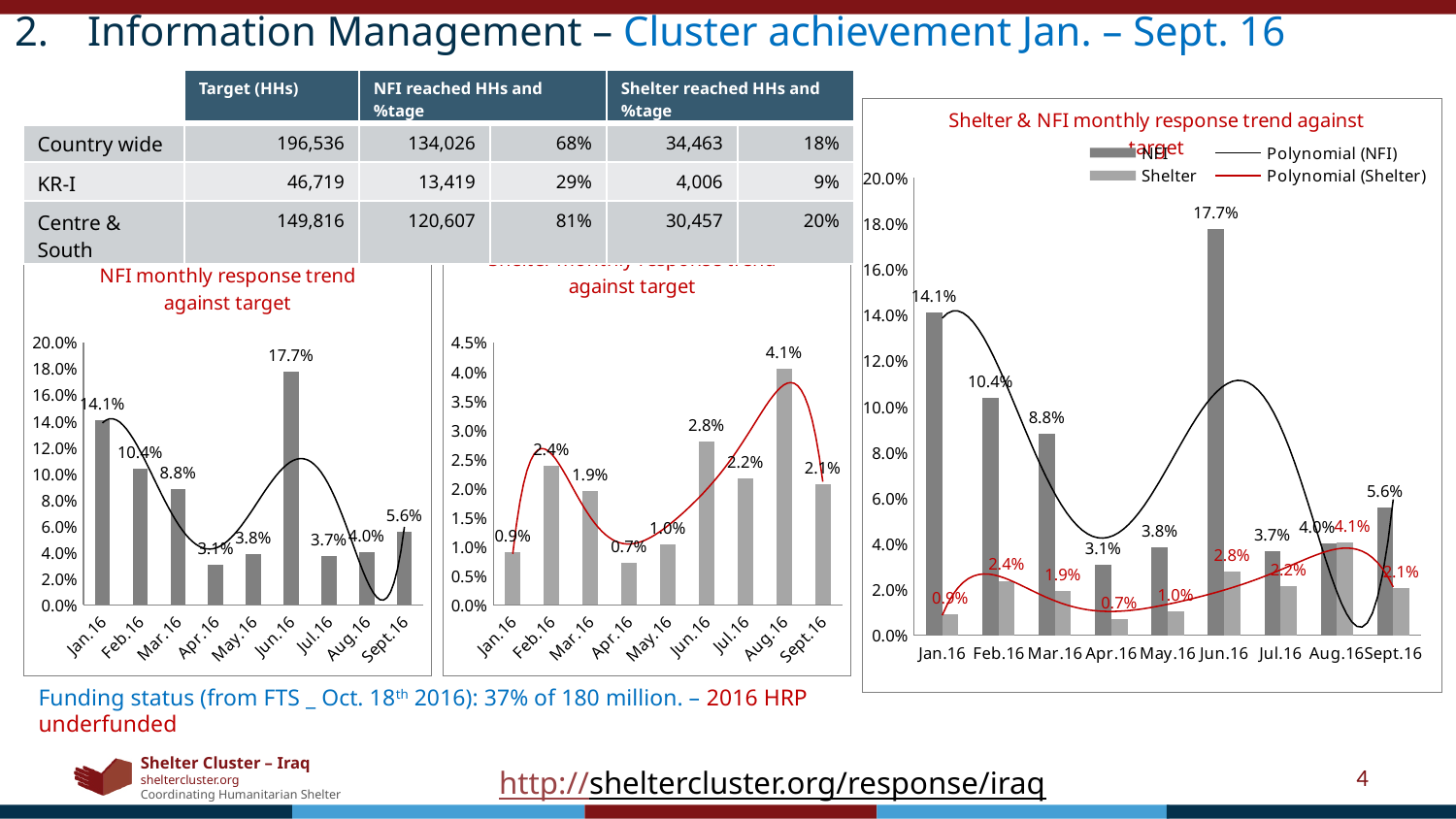
In the 'Shelter monthly response trend against target' chart, what is the value for Aug.16? 4.1% In the 'Shelter & NFI monthly response trend against target' chart, how many entries does the legend list? 4 In the 'NFI monthly response trend against target' chart, what is the difference between the Jan.16 and Feb.16 values? 3.7% In the 'Shelter monthly response trend against target' chart, which is larger, the value for Feb.16 or the value for Jul.16? Feb.16 In the 'Shelter monthly response trend against target' chart, which month has the lowest value? Apr.16 What type of chart is the 'NFI monthly response trend against target' chart? Bar chart In the 'NFI monthly response trend against target' chart, which month has the lowest value? Apr.16 In the 'Shelter monthly response trend against target' chart, what is the difference between the Jun.16 and May.16 values? 1.8% In the 'NFI monthly response trend against target' chart, what is the value for Jun.16? 17.7% In the 'Shelter & NFI monthly response trend against target' chart, is the NFI value for Jan.16 greater or less than 12.0%? greater In the 'NFI monthly response trend against target' chart, how many months are plotted on the x axis? 9 In the 'Shelter & NFI monthly response trend against target' chart, what is the Shelter value for Sept.16? 2.1%